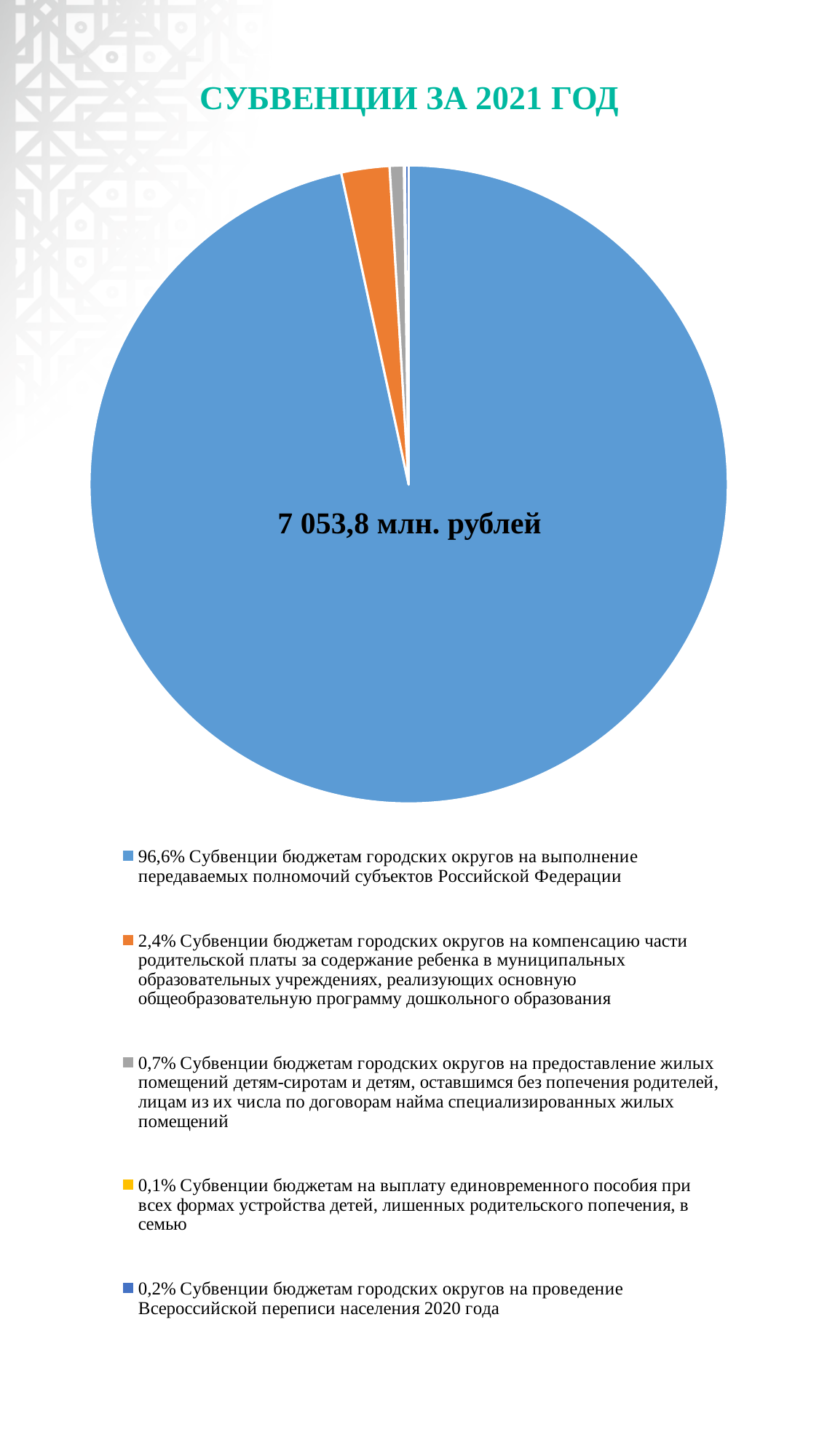
What share of the pie is 'Субвенции бюджетам городских округов на предоставление жилых помещений детям-сиротам и детям, оставшимся без попечения родителей'? 0,7% What total amount is printed in the centre of the pie chart? 7 053,8 млн. рублей What is the title of the chart? СУБВЕНЦИИ ЗА 2021 ГОД What kind of chart is shown on the slide? pie chart What is the difference in percentage points between the 2,4% share and the 0,7% share? 1,7 Which share is larger: the subvention for housing for orphans (детям-сиротам) or the subvention for the 2020 census (переписи населения)? детям-сиротам (0,7%) Which category has the smallest share of the pie? Субвенции бюджетам на выплату единовременного пособия при всех формах устройства детей, лишенных родительского попечения, в семью (0,1%) What share of the pie is 'Субвенции бюджетам городских округов на проведение Всероссийской переписи населения 2020 года'? 0,2% Which category has the largest share of the pie? Субвенции бюджетам городских округов на выполнение передаваемых полномочий субъектов Российской Федерации (96,6%) How many categories does the legend of the pie chart list? 5 By how many percentage points does the share for 'выполнение передаваемых полномочий субъектов Российской Федерации' exceed the share for 'компенсацию части родительской платы'? 94,2 What share of the pie is 'Субвенции бюджетам городских округов на компенсацию части родительской платы за содержание ребенка в муниципальных образовательных учреждениях'? 2,4%